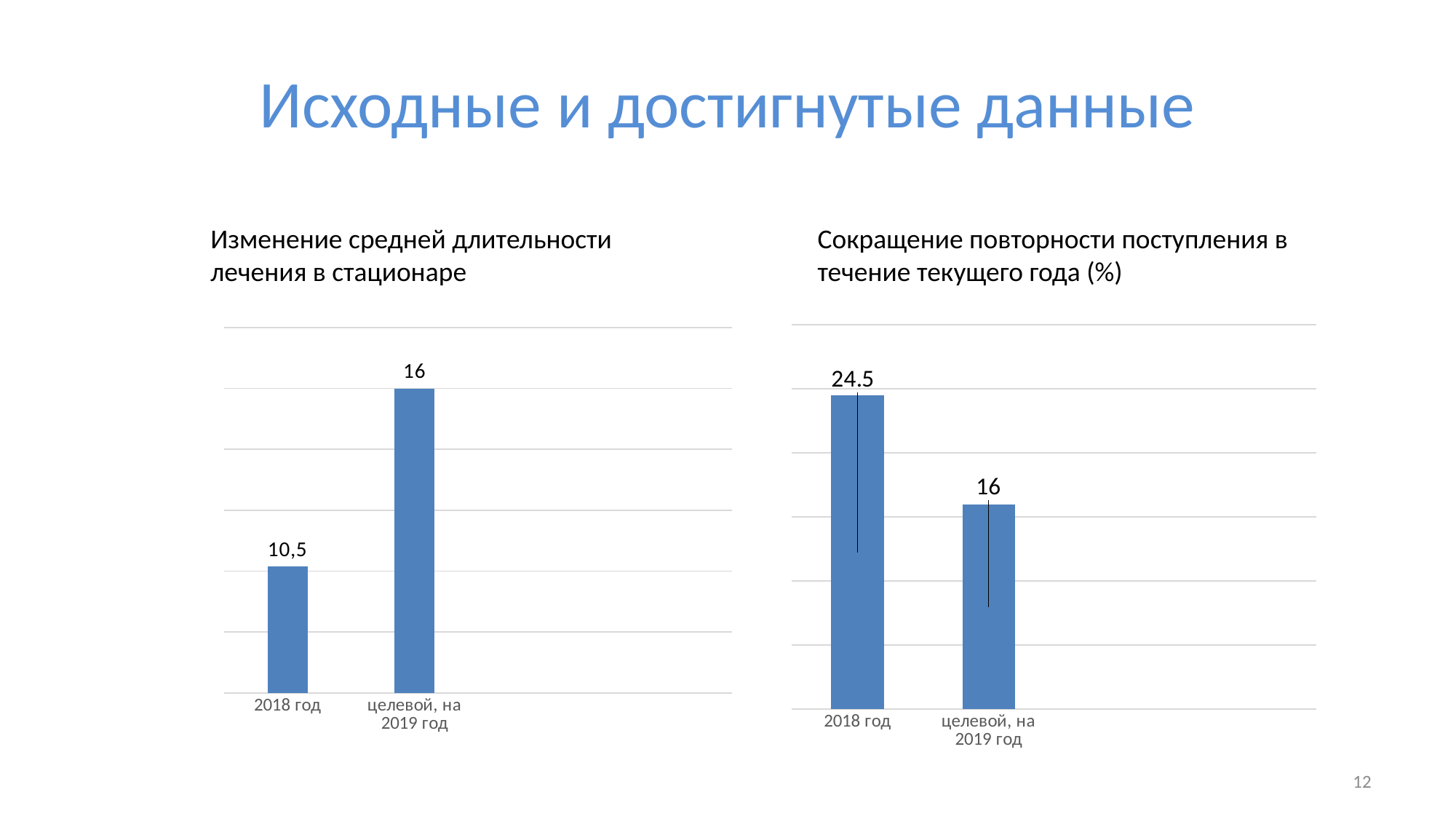
What kind of chart is the right chart? bar chart In the right chart (Сокращение повторности поступления в течение текущего года (%)), what is the value for целевой, на 2019 год? 16 In the right chart, which is larger: the value for 2018 год or the value for целевой, на 2019 год? 2018 год In the right chart, which category has the lowest value? целевой, на 2019 год In the right chart (Сокращение повторности поступления в течение текущего года (%)), what is the value for 2018 год? 24.5 In the left chart, what is the difference between the value for целевой, на 2019 год and the value for 2018 год? 5,5 How many categories are shown in the left chart? 2 In the right chart, what is the difference between the value for 2018 год and the value for целевой, на 2019 год? 8.5 In the right chart, do the values rise or fall from 2018 год to целевой, на 2019 год? fall In the left chart, which category has the highest value? целевой, на 2019 год In the left chart (Изменение средней длительности лечения в стационаре), what is the value for целевой, на 2019 год? 16 In the left chart (Изменение средней длительности лечения в стационаре), what is the value for 2018 год? 10,5